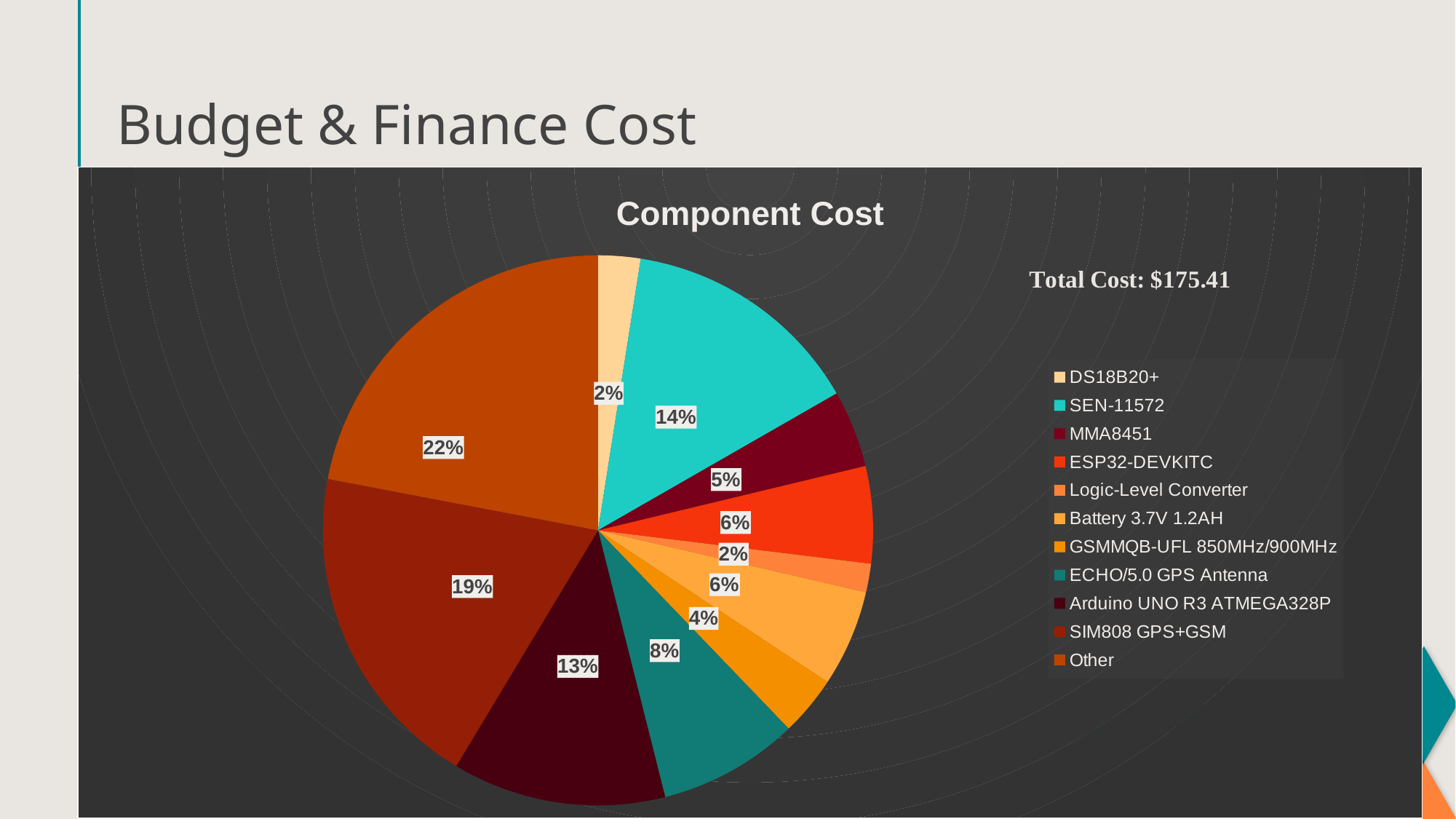
What percentage is shown for ECHO/5.0 GPS Antenna? 8% What percentage is shown for Arduino UNO R3 ATMEGA328P? 13% How many slices does the pie chart have? 11 How many entries does the legend list? 11 What is the difference in percentage points between Other and SIM808 GPS+GSM? 3 What share of the pie does SEN-11572 represent? 14% What is the title of the chart? Component Cost Which category has the largest slice of the pie? Other What percentage is shown for SIM808 GPS+GSM? 19% What total cost is stated on the slide next to the chart? $175.41 Which is larger, the share for MMA8451 or the share for ESP32-DEVKITC? ESP32-DEVKITC What kind of chart is shown on the slide? pie chart